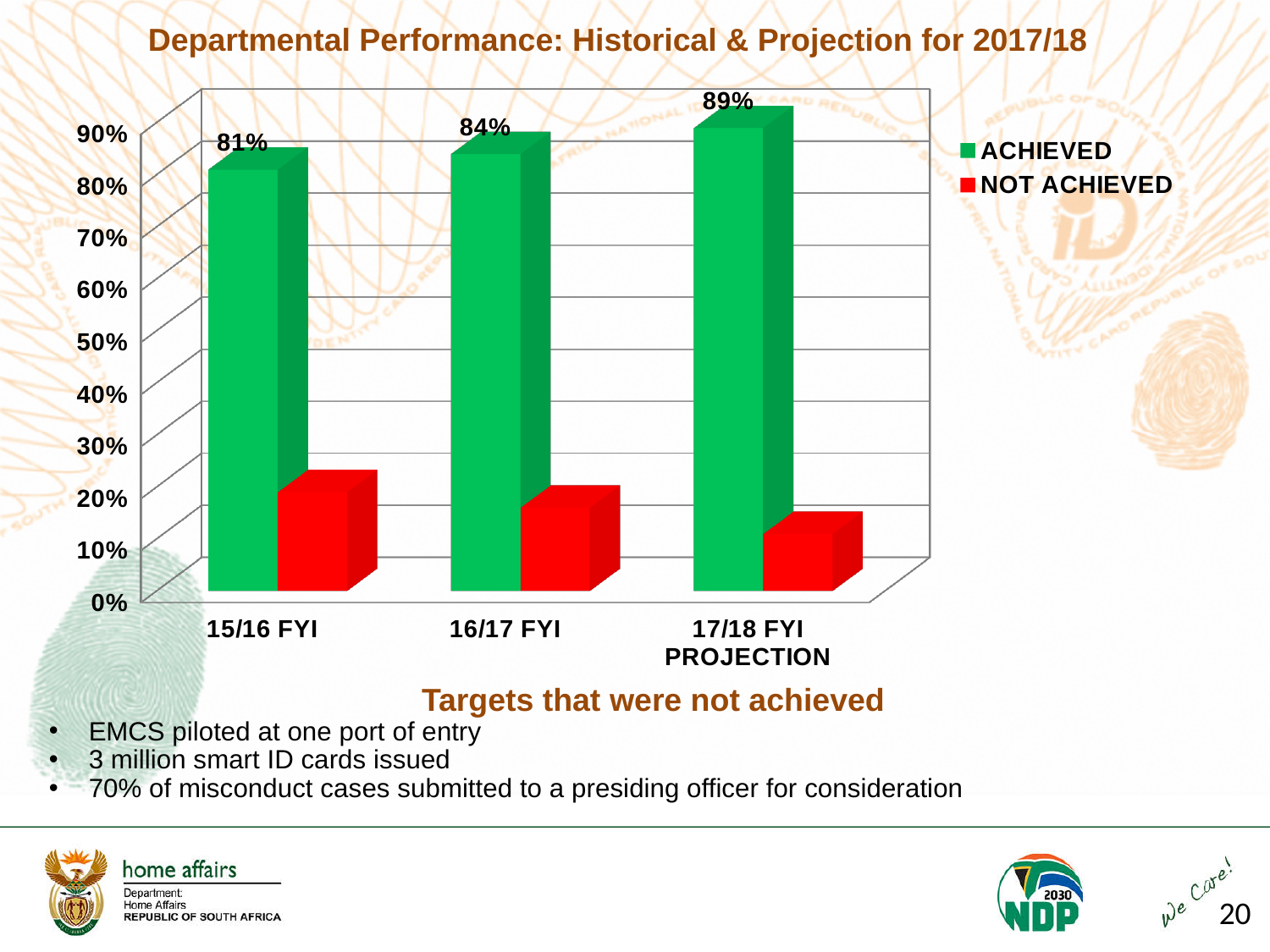
What is the difference between the ACHIEVED values for 17/18 FYI PROJECTION and 15/16 FYI? 8% What is the ACHIEVED value for 15/16 FYI? 81% How many categories are shown on the x axis of the chart? 3 What is the ACHIEVED value for 17/18 FYI PROJECTION? 89% How many series does the chart legend list? 2 Which is larger, the ACHIEVED value for 16/17 FYI or for 15/16 FYI? 16/17 FYI Which category has the lowest ACHIEVED value? 15/16 FYI Is the NOT ACHIEVED value for 15/16 FYI greater or less than 30%? less Which category has the highest ACHIEVED value? 17/18 FYI PROJECTION Is the NOT ACHIEVED value for 17/18 FYI PROJECTION greater or less than 20%? less What is the ACHIEVED value for 16/17 FYI? 84% What kind of chart is shown on the slide? bar chart